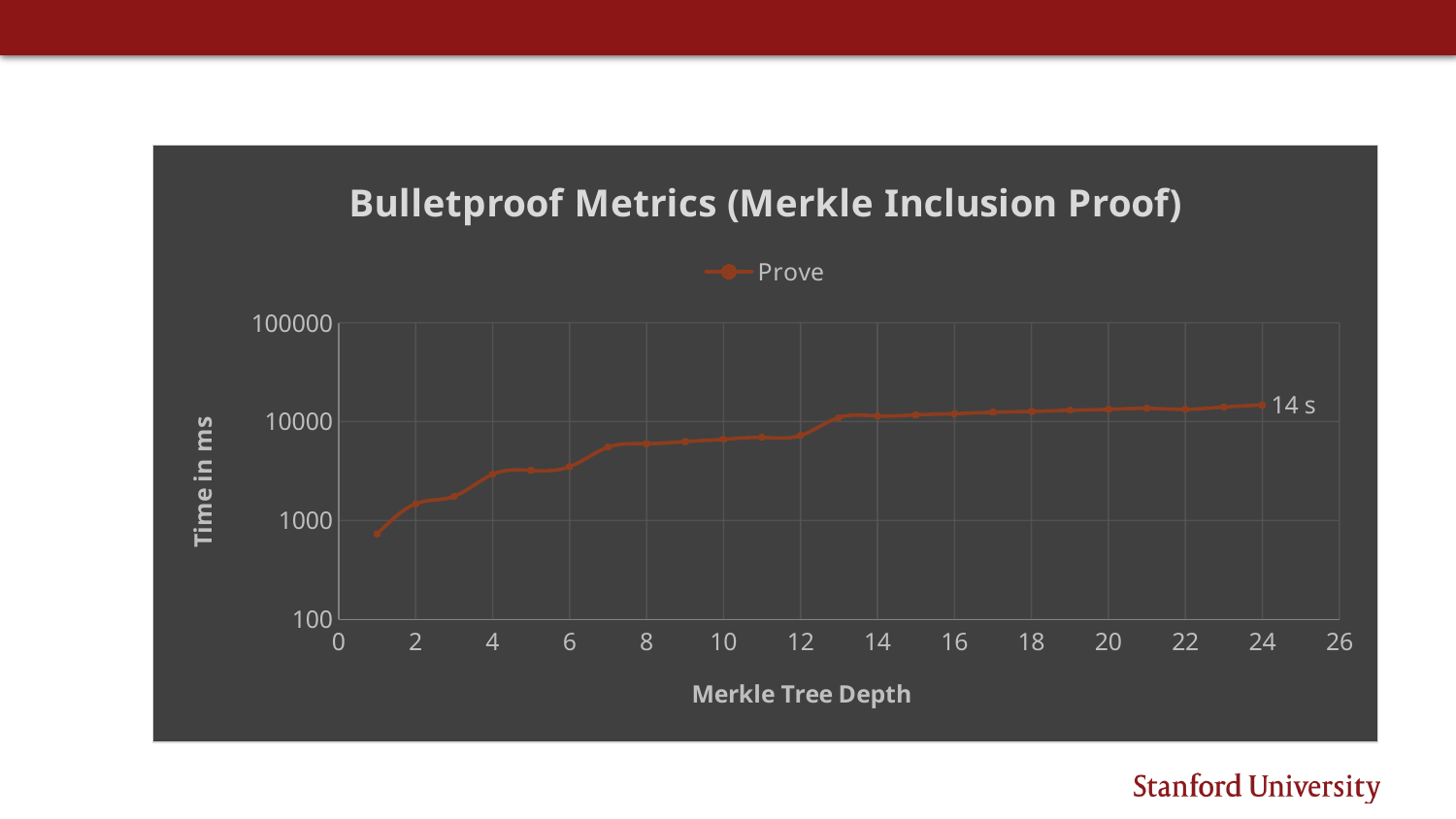
Is the Prove time at Merkle Tree Depth 24 greater or less than 10000 ms? greater Which has a larger Prove time: Merkle Tree Depth 4 or Merkle Tree Depth 14? Merkle Tree Depth 14 How many series does the legend list? 1 Does the Prove time rise or fall as Merkle Tree Depth increases? rise What kind of chart is shown on the slide? line chart Is the Prove time at Merkle Tree Depth 1 greater or less than 1000 ms? less What is the title of the chart? Bulletproof Metrics (Merkle Inclusion Proof) At which Merkle Tree Depth is the Prove time lowest? 1 Is the Prove time at Merkle Tree Depth 8 greater or less than 10000 ms? less At which Merkle Tree Depth is the Prove time highest? 24 What is the name of the series shown in the legend? Prove How many data points are plotted on the Prove line? 24